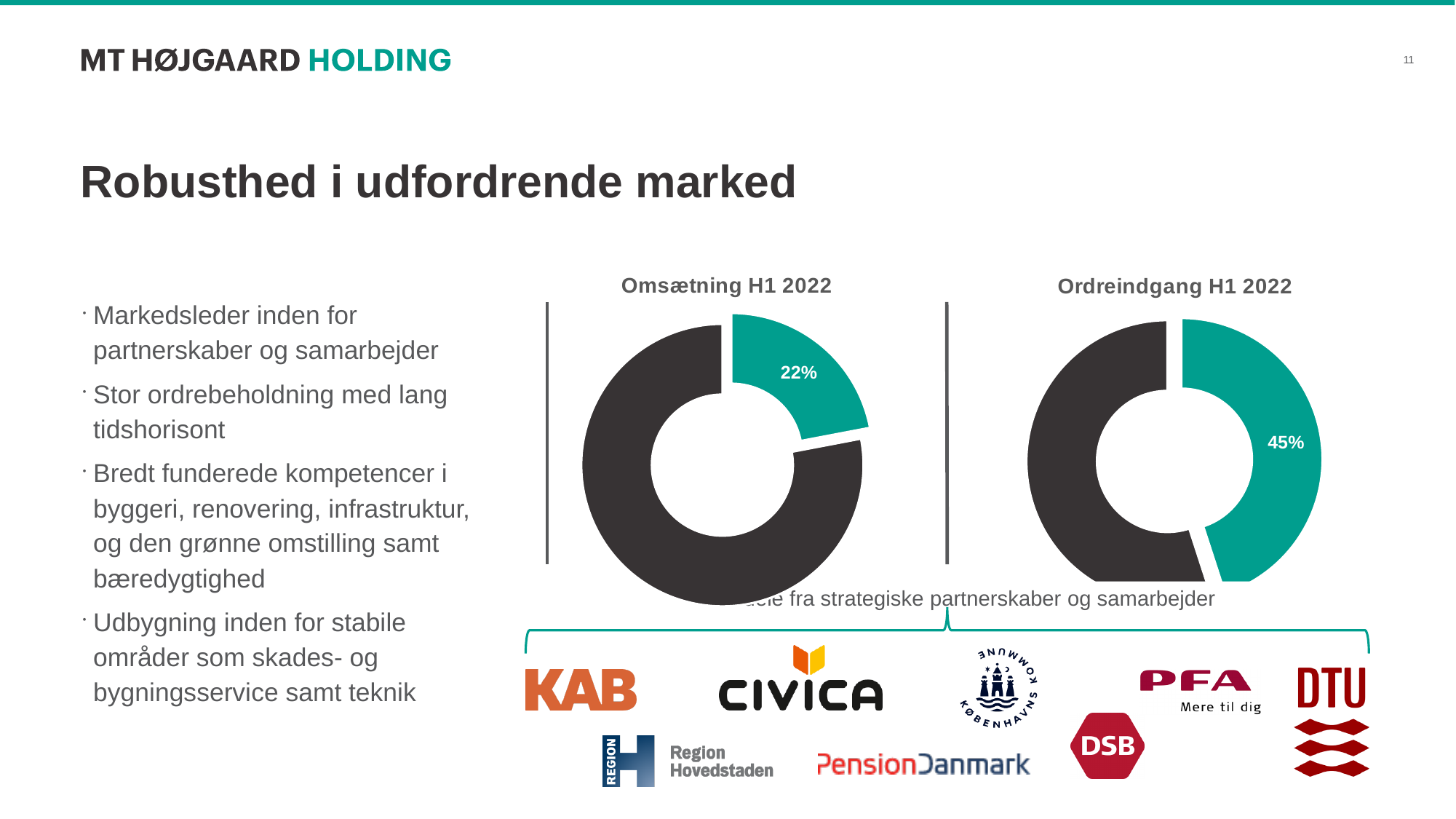
What is the title of the right donut chart on the slide? Ordreindgang H1 2022 What kind of chart is the Omsætning H1 2022 chart? Donut (pie) chart What is the title of the left donut chart on the slide? Omsætning H1 2022 In the Omsætning H1 2022 chart, what percentage is shown on the teal slice? 22% In the Omsætning H1 2022 chart, is the teal slice greater or less than 25% of the donut? less In the Ordreindgang H1 2022 chart, is the teal slice greater or less than 50% of the donut? less How many percentage points higher is the labelled share in the Ordreindgang H1 2022 chart than in the Omsætning H1 2022 chart? 23 percentage points What kind of chart is the Ordreindgang H1 2022 chart? Donut (pie) chart Which chart shows a larger teal share, Omsætning H1 2022 or Ordreindgang H1 2022? Ordreindgang H1 2022 In the Ordreindgang H1 2022 chart, what percentage is shown on the teal slice? 45% How many slices does the Ordreindgang H1 2022 donut chart have? 2 How many slices does the Omsætning H1 2022 donut chart have? 2